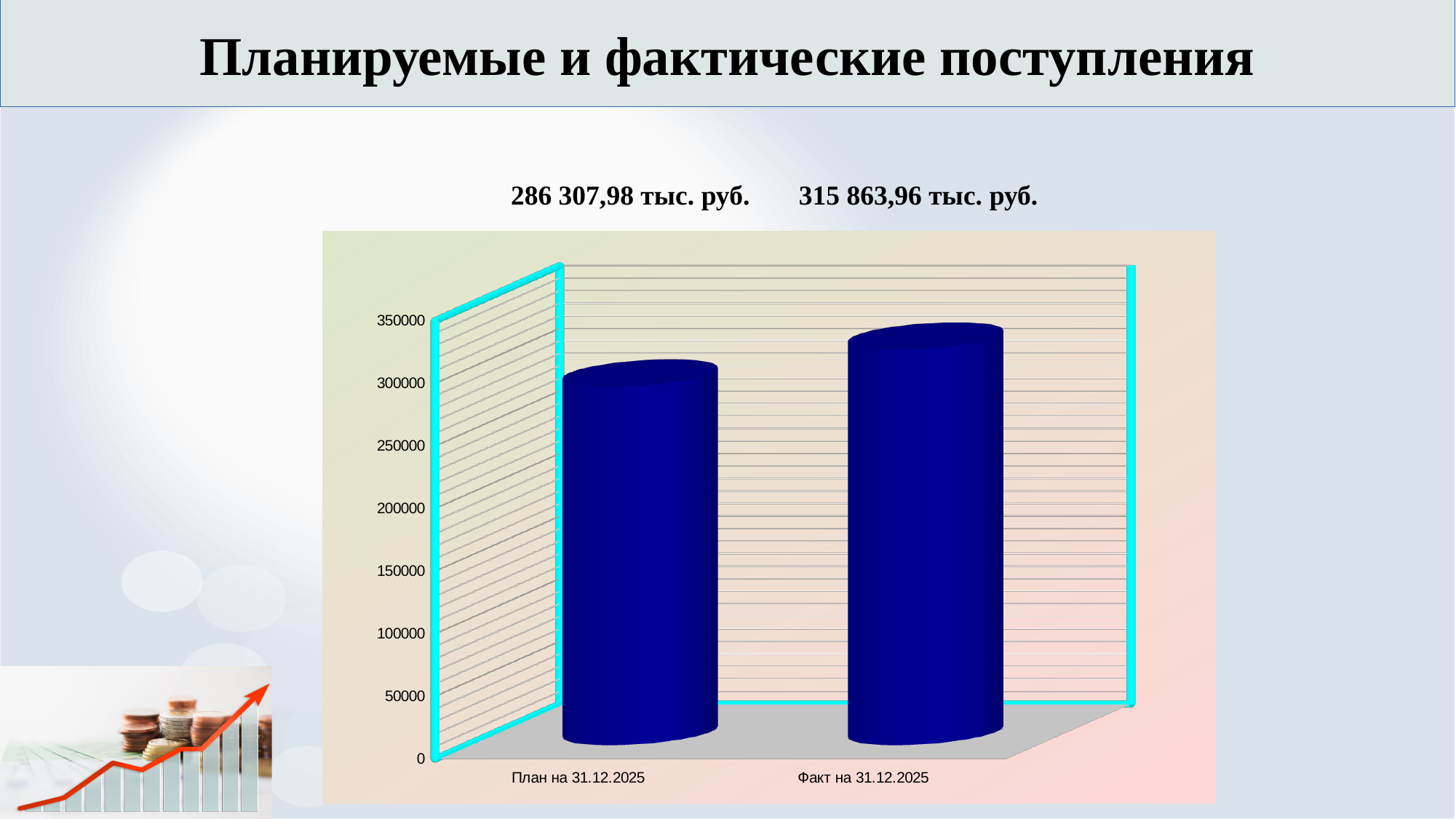
What is the value for План на 31.12.2025? 286 307,98 тыс. руб. What is the title of the slide? Планируемые и фактические поступления How many categories are shown on the chart? 2 Which is larger, the value for План на 31.12.2025 or the value for Факт на 31.12.2025? Факт на 31.12.2025 Which category has the highest value? Факт на 31.12.2025 What kind of chart is shown on the slide? bar chart Is the value for Факт на 31.12.2025 greater or less than 350000? less Is the value for План на 31.12.2025 greater or less than 250000? greater What is the highest value shown on the vertical axis? 350000 Which category has the lowest value? План на 31.12.2025 What is the difference between the value for Факт на 31.12.2025 and the value for План на 31.12.2025? 29 555,98 тыс. руб. What is the value for Факт на 31.12.2025? 315 863,96 тыс. руб.